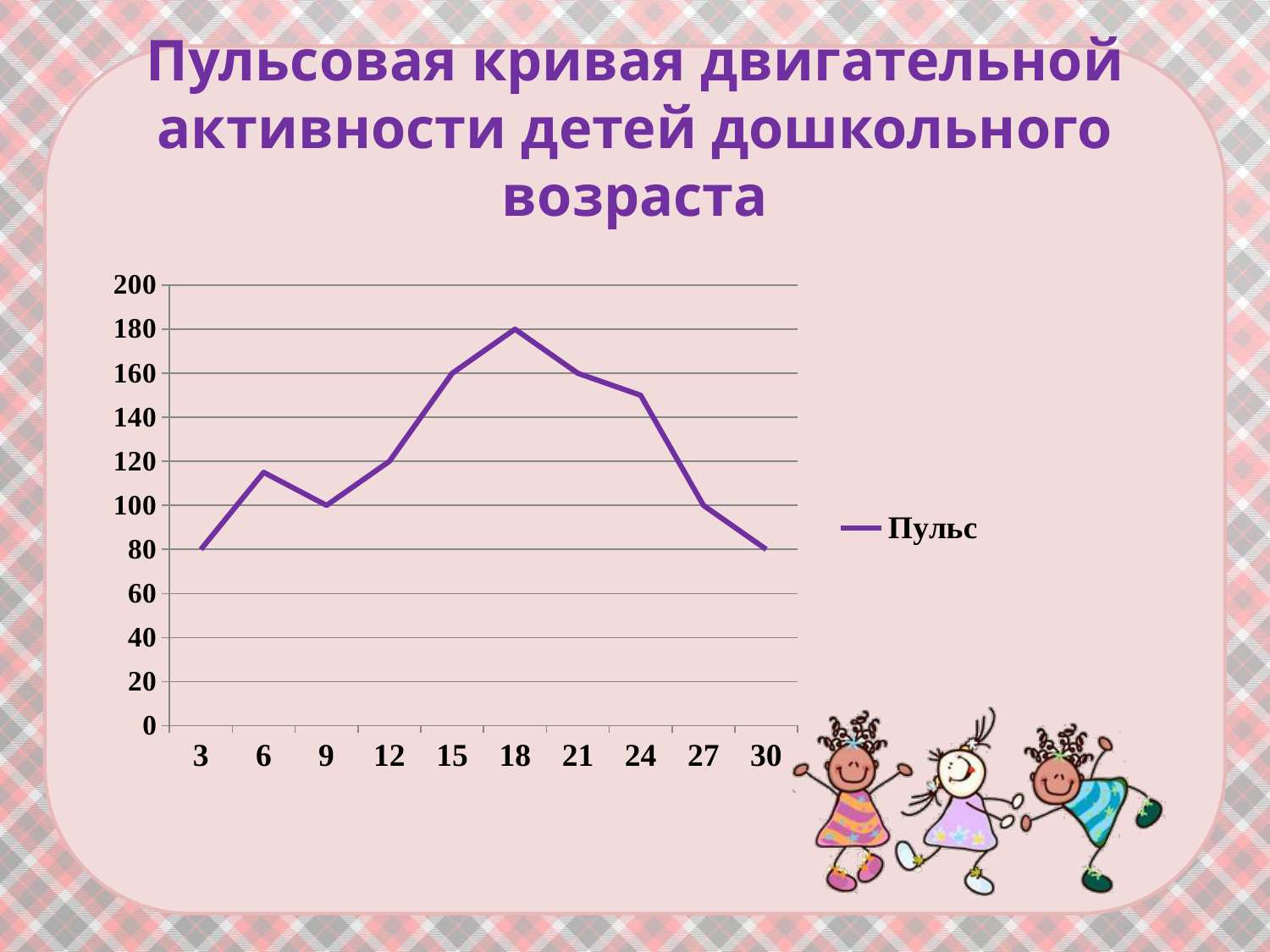
What is the name of the series shown in the legend? Пульс At which x-axis value does the pulse reach its highest point? 18 Is the pulse value at x = 6 greater or less than 100? greater Which is larger, the pulse value at x = 12 or at x = 27? x = 12 How many data points are plotted along the x axis? 10 What is the difference between the pulse value at x = 18 and at x = 30? 100 What is the pulse value at x = 18? 180 How many series does the legend list? 1 What is the pulse value at x = 3? 80 Is the pulse value at x = 24 greater or less than 160? less What kind of chart is shown on the slide? line chart What is the pulse value at x = 15? 160